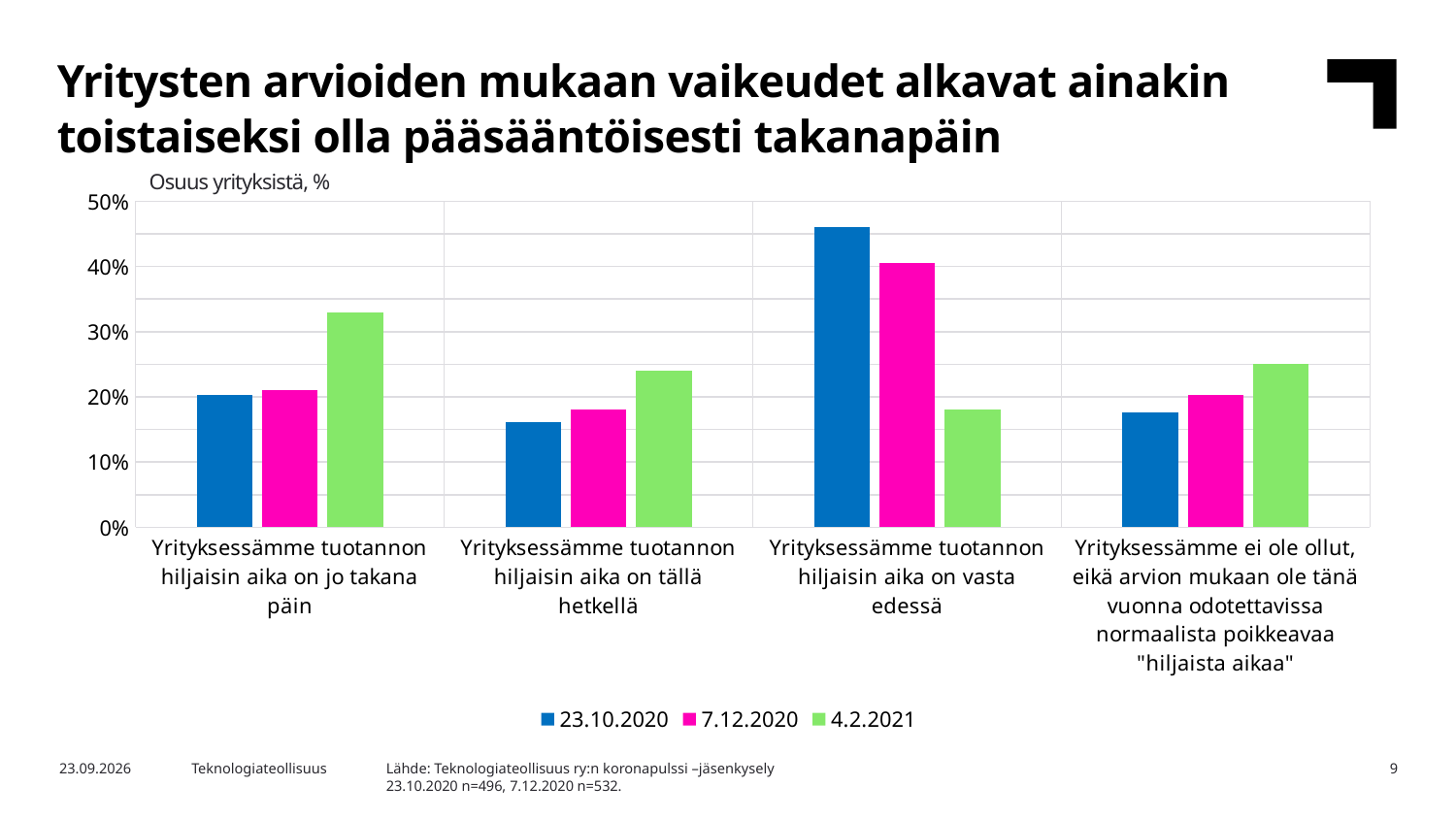
What kind of chart is shown on the slide? bar chart Is the 4.2.2021 value for "Yrityksessämme tuotannon hiljaisin aika on jo takana päin" greater or less than 30%? greater Which category has the highest value for the 4.2.2021 series? Yrityksessämme tuotannon hiljaisin aika on jo takana päin How many series does the legend list? 3 How many categories are shown on the x axis? 4 What is the label shown above the vertical axis of the chart? Osuus yrityksistä, % Which category has the highest value for the 23.10.2020 series? Yrityksessämme tuotannon hiljaisin aika on vasta edessä Is the 23.10.2020 value for "Yrityksessämme tuotannon hiljaisin aika on vasta edessä" greater or less than 40%? greater For "Yrityksessämme tuotannon hiljaisin aika on vasta edessä", which series has the larger value: 23.10.2020 or 4.2.2021? 23.10.2020 Which category has the lowest value for the 4.2.2021 series? Yrityksessämme tuotannon hiljaisin aika on vasta edessä Is the 7.12.2020 value for "Yrityksessämme tuotannon hiljaisin aika on tällä hetkellä" greater or less than 20%? less For "Yrityksessämme tuotannon hiljaisin aika on vasta edessä", do the values rise or fall from 23.10.2020 to 4.2.2021? fall